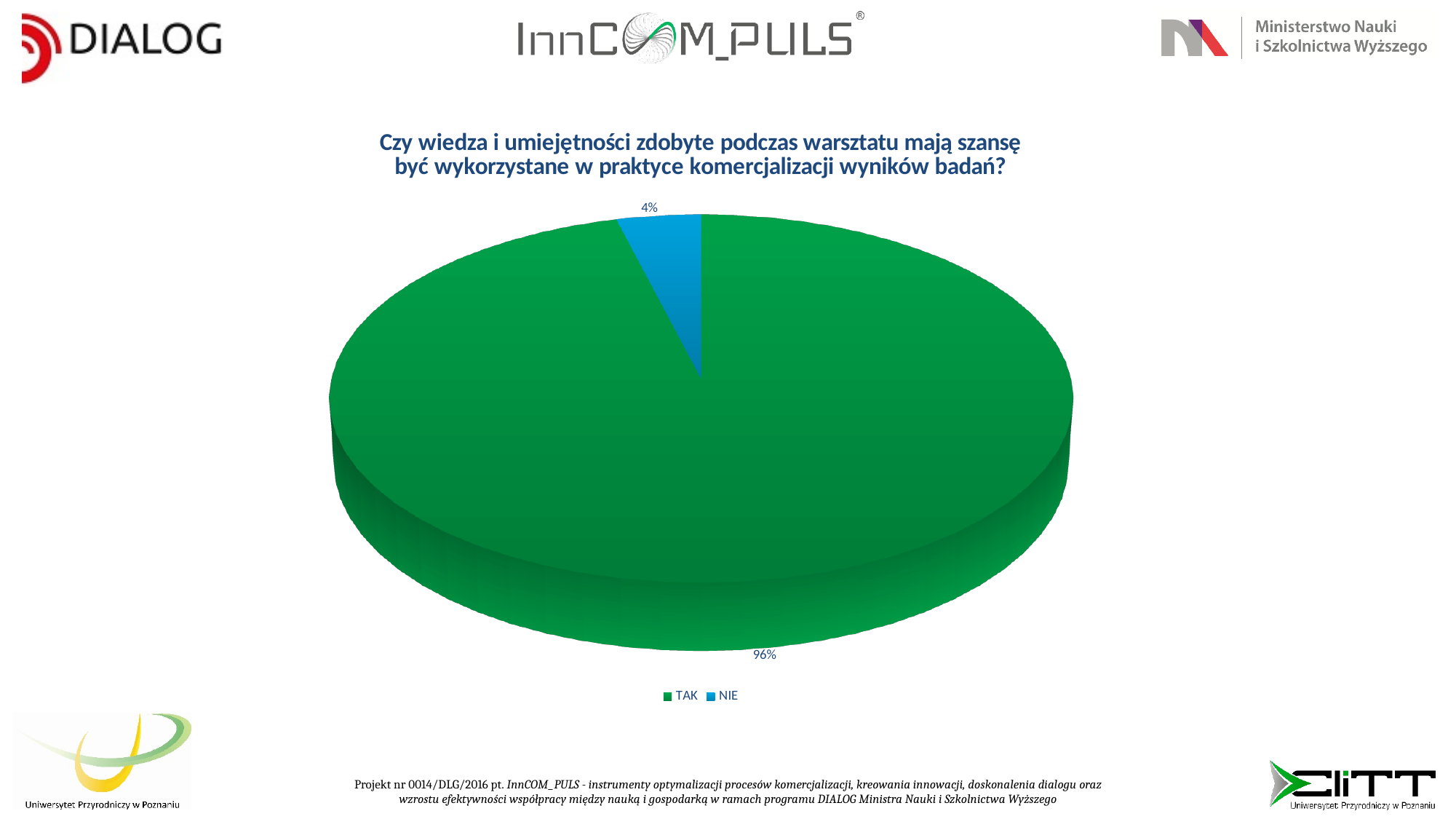
What kind of chart is shown on the slide? Pie chart What colour is the TAK slice? Green How many entries does the legend list? 2 What is the difference in percentage points between the TAK and NIE slices? 92 What share of the pie does NIE represent? 4% What colour is the NIE slice? Blue What share of the pie does TAK represent? 96% Which category has the largest slice of the pie? TAK Which is larger, the TAK slice or the NIE slice? TAK Which category has the smallest slice of the pie? NIE How many slices does the pie chart have? 2